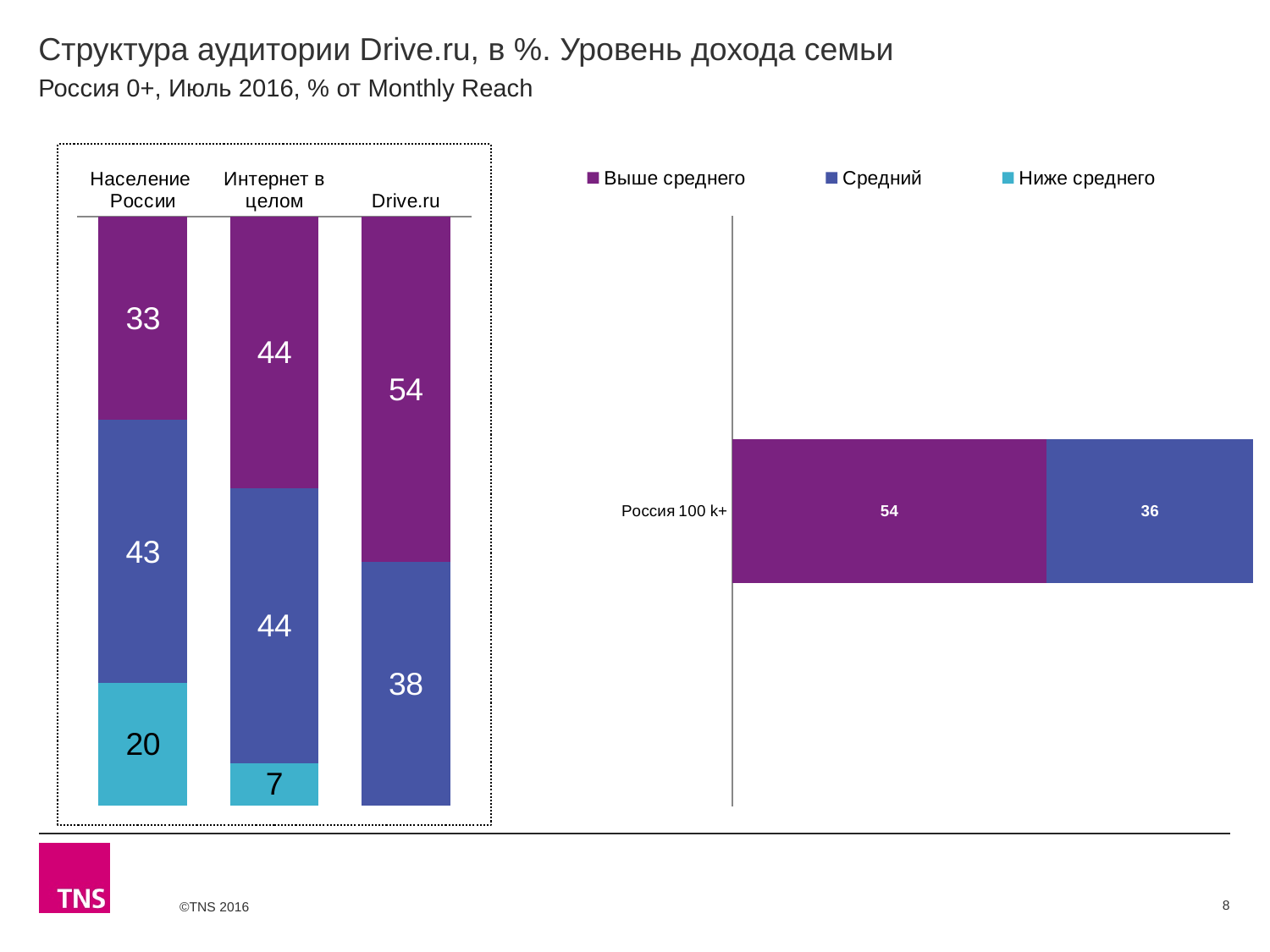
In the left chart, which is larger: the 'Средний' value for 'Население России' or for Drive.ru? Население России In the left chart, what is the value of the 'Средний' segment for 'Интернет в целом'? 44 In the left chart, which category has the highest 'Выше среднего' value? Drive.ru In the left chart, what is the total of the stacked bar for 'Население России'? 96 How many series does the legend list? 3 How many categories are shown in the left chart? 3 What kind of chart is the right chart? Stacked horizontal bar chart In the right chart, what is the 'Средний' value for 'Россия 100 k+'? 36 In the left chart, which category has the lowest 'Ниже среднего' value among those with a printed label? Интернет в целом In the left chart, what is the difference between the 'Выше среднего' values for Drive.ru and 'Население России'? 21 In the left chart, what is the value of the 'Ниже среднего' segment for 'Население России'? 20 In the left chart, what is the value of the 'Выше среднего' segment for Drive.ru? 54